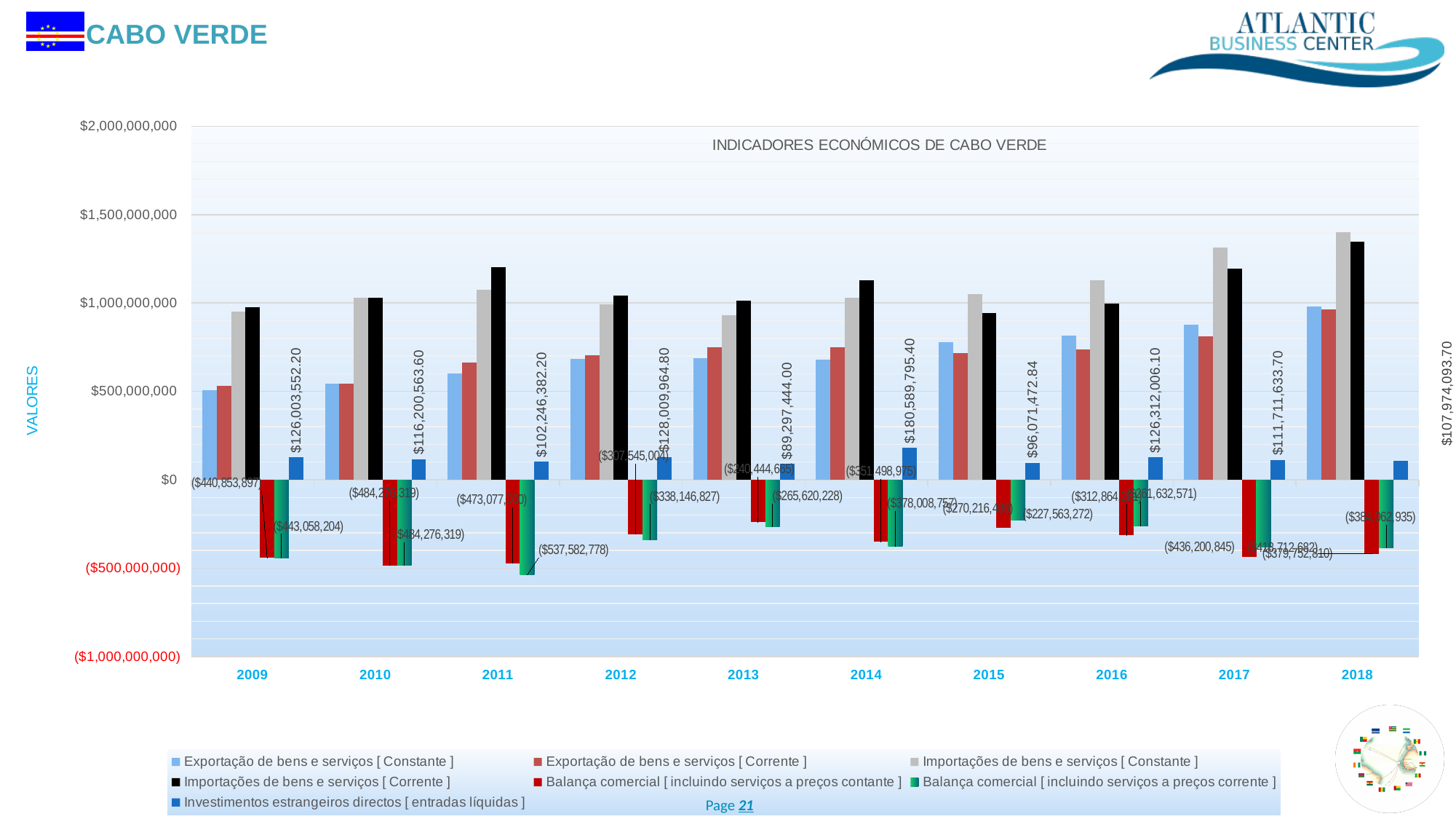
In which year is Investimentos estrangeiros directos [entradas líquidas] highest? 2014 What kind of chart is shown on the slide? bar chart What is the title of the chart? INDICADORES ECONÓMICOS DE CABO VERDE What is the difference between Investimentos estrangeiros directos in 2014 and in 2013? $91,292,351.40 Which year has the larger value of Investimentos estrangeiros directos, 2009 or 2010? 2009 How many series does the chart legend list? 7 How many years are shown on the x axis of the chart? 10 In which year is Investimentos estrangeiros directos [entradas líquidas] lowest? 2013 What is the value of Investimentos estrangeiros directos [entradas líquidas] for 2014? $180,589,795.40 Does Exportação de bens e serviços [Constante] generally rise or fall from 2009 to 2018? rise What is the value of Investimentos estrangeiros directos [entradas líquidas] for 2013? $89,297,444.00 Is the value of Importações de bens e serviços [Constante] for 2018 greater or less than $1,000,000,000? greater